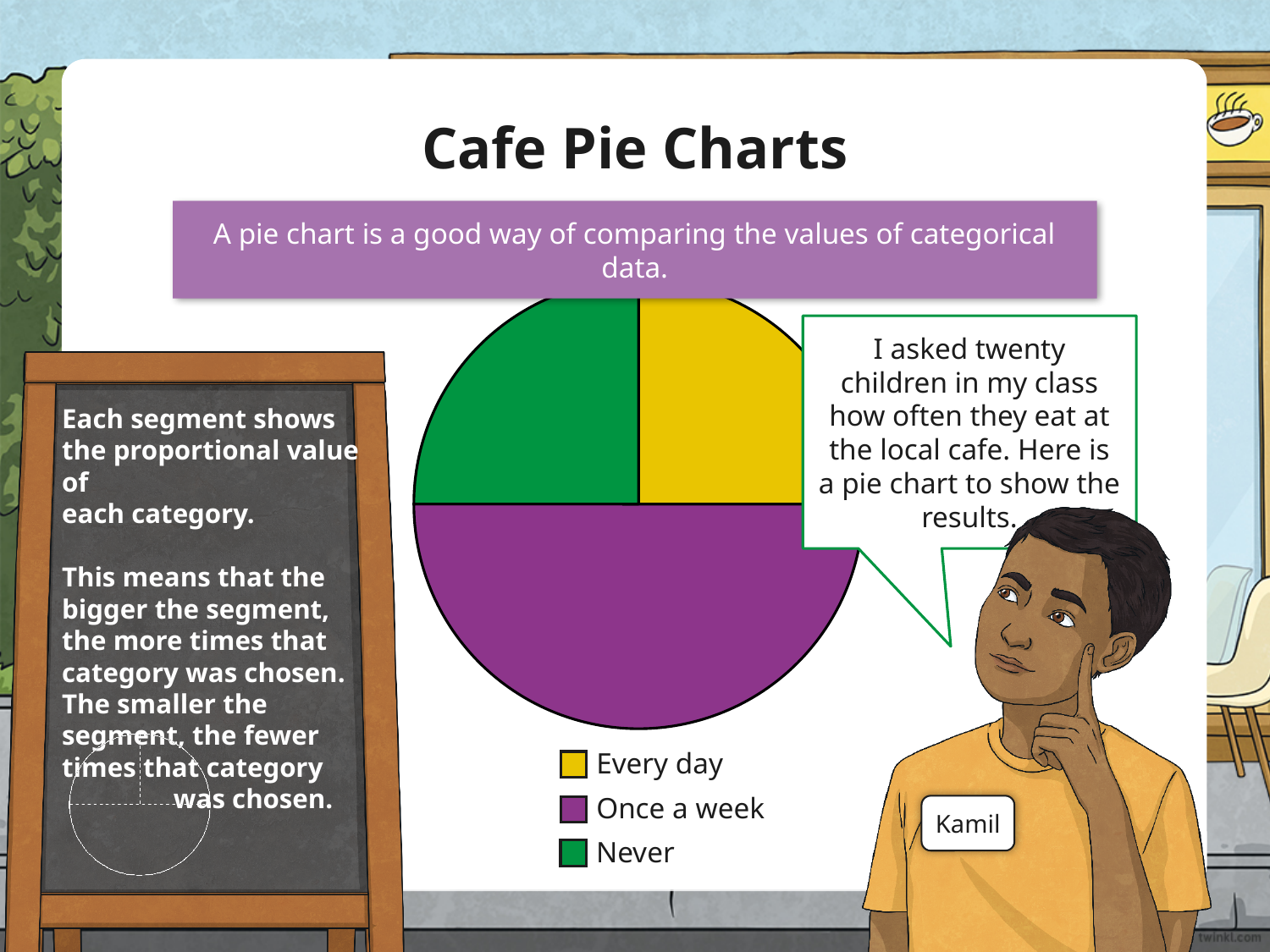
Which is larger, the slice for Once a week or the slice for Every day? Once a week Which is larger, the slice for Never or the slice for Once a week? Once a week Which category has the largest slice of the pie chart? Once a week How many entries does the legend list? 3 Which category is shown in yellow in the pie chart? Every day What kind of chart is shown on the slide? pie chart How many categories does the pie chart show? 3 What colour is the slice for Never in the pie chart? green